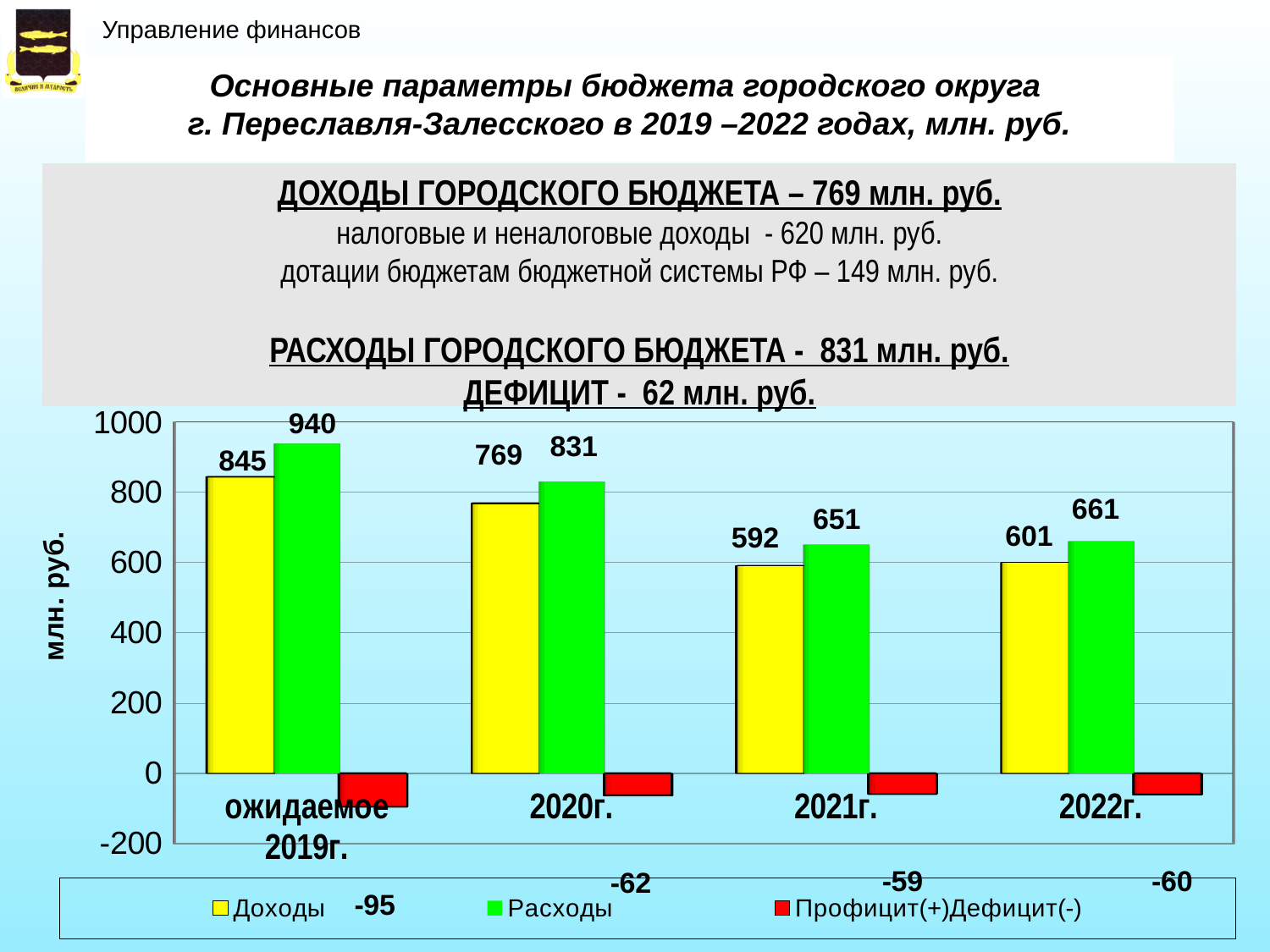
What kind of chart is shown on the slide? bar chart Which is larger, Доходы for 2021г. or Доходы for 2022г.? Доходы for 2022г. What is the value of Расходы for 2022г.? 661 Which category has the highest value for Доходы? ожидаемое 2019г. Which category has the lowest value for Расходы? 2021г. What is the y-axis label of the chart? млн. руб. How many series does the legend list? 3 What is the value of Профицит(+)Дефицит(-) for 2021г.? -59 How many categories are shown on the x axis? 4 What is the difference between Расходы and Доходы for 2020г.? 62 What is the value of Доходы for 2020г.? 769 What is the value of Расходы for ожидаемое 2019г.? 940